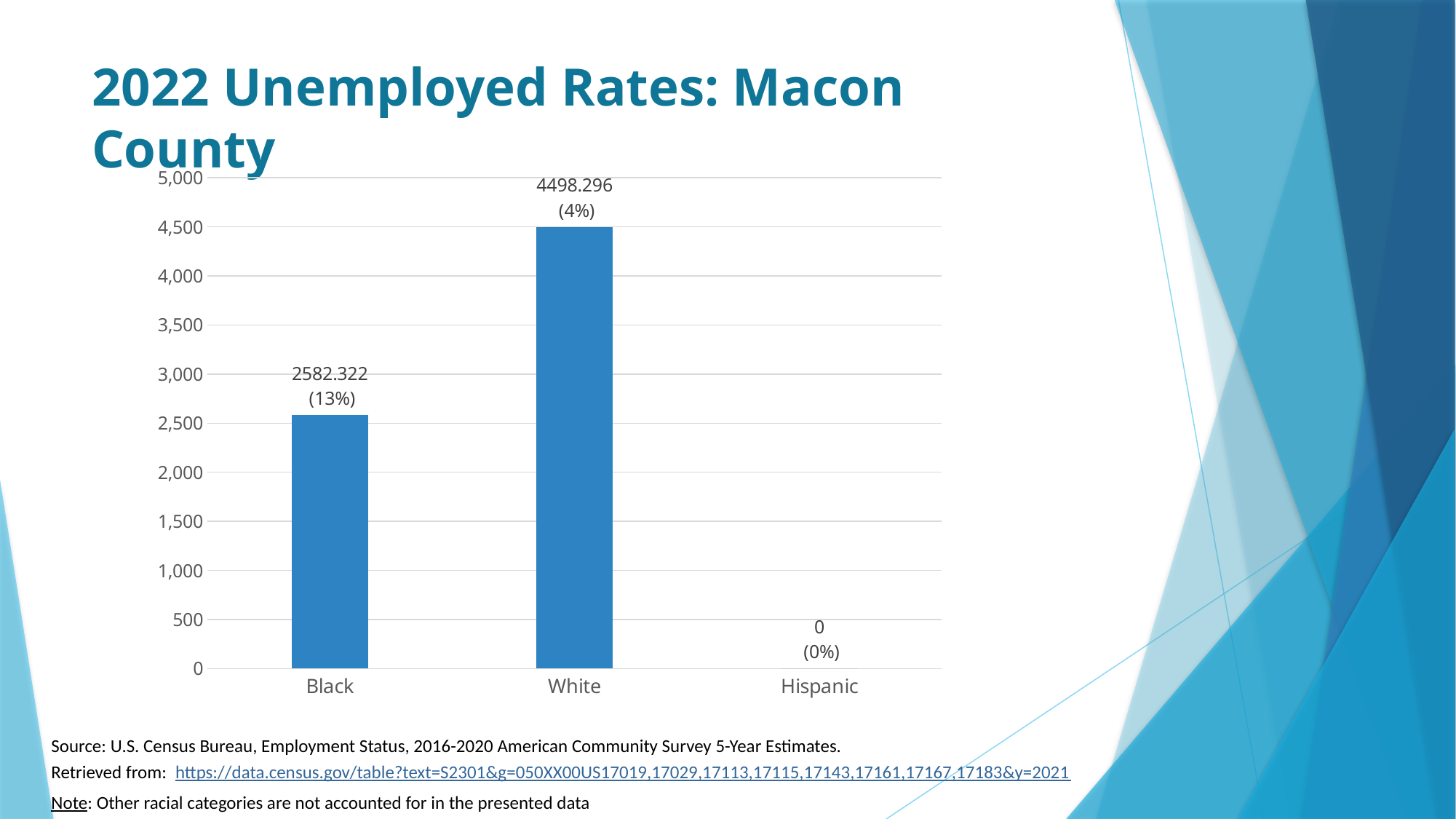
Which category has the lowest value? Hispanic What is the value shown for Black? 2582.322 What kind of chart is shown on the slide? bar chart Which category has the highest value? White What percentage is shown in parentheses for White? 4% Is the value for Black greater or less than 3,000? less What is the value shown for White? 4498.296 What is the difference between the values for White and Black? 1915.974 What percentage is shown in parentheses for Black? 13% What is the value shown for Hispanic? 0 How many categories are shown on the x axis? 3 Which is larger, the value for Black or the value for White? White